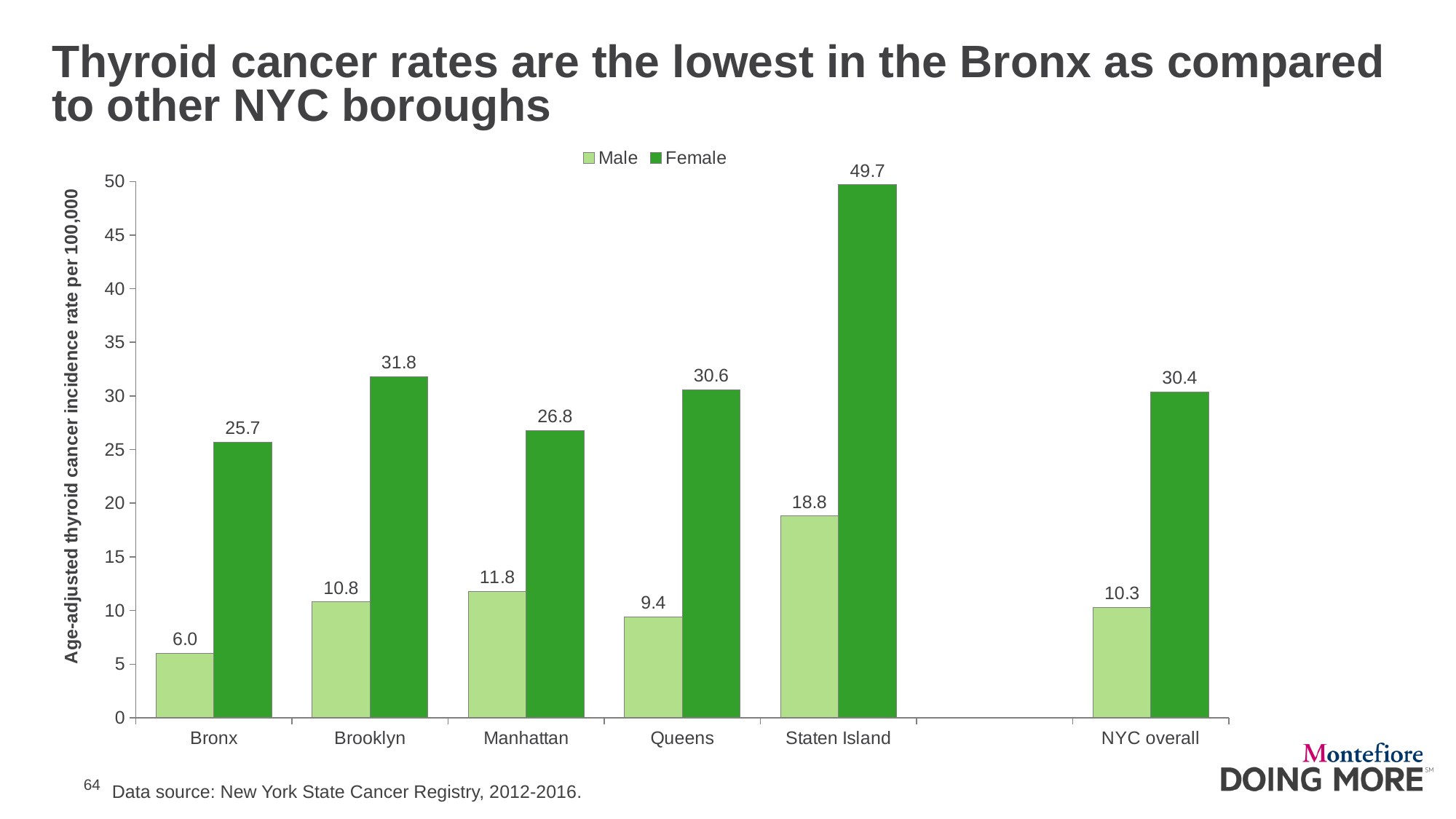
Is the Female rate for Queens greater or less than 30? greater What is the Female rate for NYC overall? 30.4 Which is larger, the Male rate for Manhattan or the Male rate for Queens? Manhattan What is the label of the vertical axis? Age-adjusted thyroid cancer incidence rate per 100,000 How many categories are shown on the x axis? 6 What is the Male thyroid cancer incidence rate for the Bronx? 6.0 Which borough has the highest Female thyroid cancer incidence rate? Staten Island What kind of chart is shown on the slide? Bar chart How many series does the legend list? 2 What is the Female thyroid cancer incidence rate for Staten Island? 49.7 What is the difference between the Female and Male rates for Brooklyn? 21.0 Which category has the lowest Male thyroid cancer incidence rate? Bronx